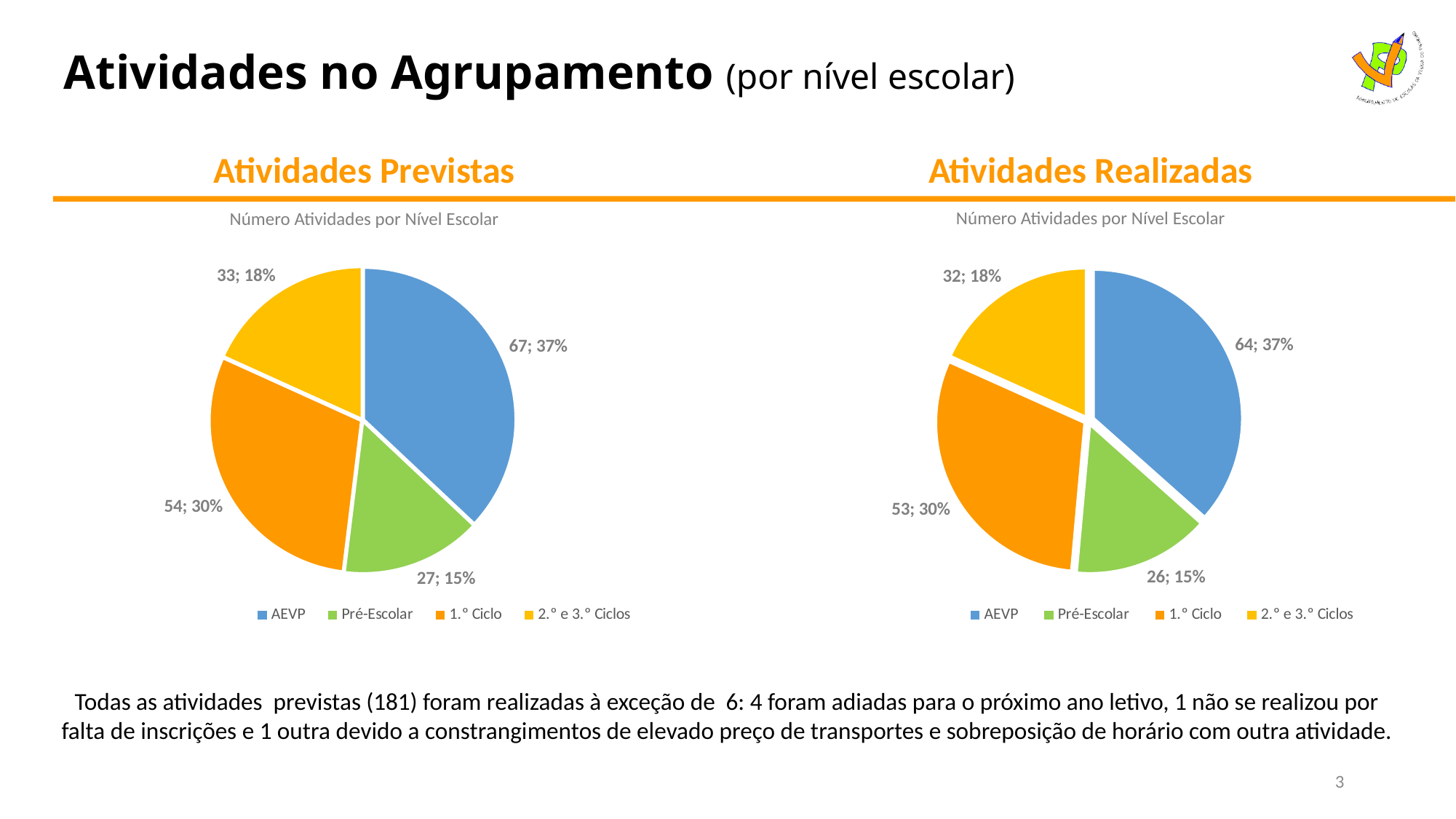
In the Atividades Realizadas pie chart on the right, which category has the smallest slice? Pré-Escolar In the Atividades Previstas pie chart on the left, what is the difference between the AEVP value and the 1.º Ciclo value? 13 In the Atividades Realizadas pie chart on the right, which is larger: the value for 2.º e 3.º Ciclos or the value for Pré-Escolar? 2.º e 3.º Ciclos In the Atividades Realizadas pie chart on the right, how many activities are shown for 2.º e 3.º Ciclos? 32 What colour is the 1.º Ciclo slice in the Atividades Previstas pie chart on the left? Orange What type of chart is used for Atividades Previstas on the left? Pie chart How many slices does the Atividades Realizadas pie chart on the right have? 4 In the Atividades Previstas pie chart on the left, how many activities are shown for AEVP? 67 What is the difference between the AEVP value in the Atividades Previstas chart on the left and the AEVP value in the Atividades Realizadas chart on the right? 3 In the Atividades Realizadas pie chart on the right, what share of the pie does 1.º Ciclo represent? 30% In the Atividades Previstas pie chart on the left, what share of the pie does Pré-Escolar represent? 15% In the Atividades Previstas pie chart on the left, which category has the largest slice? AEVP